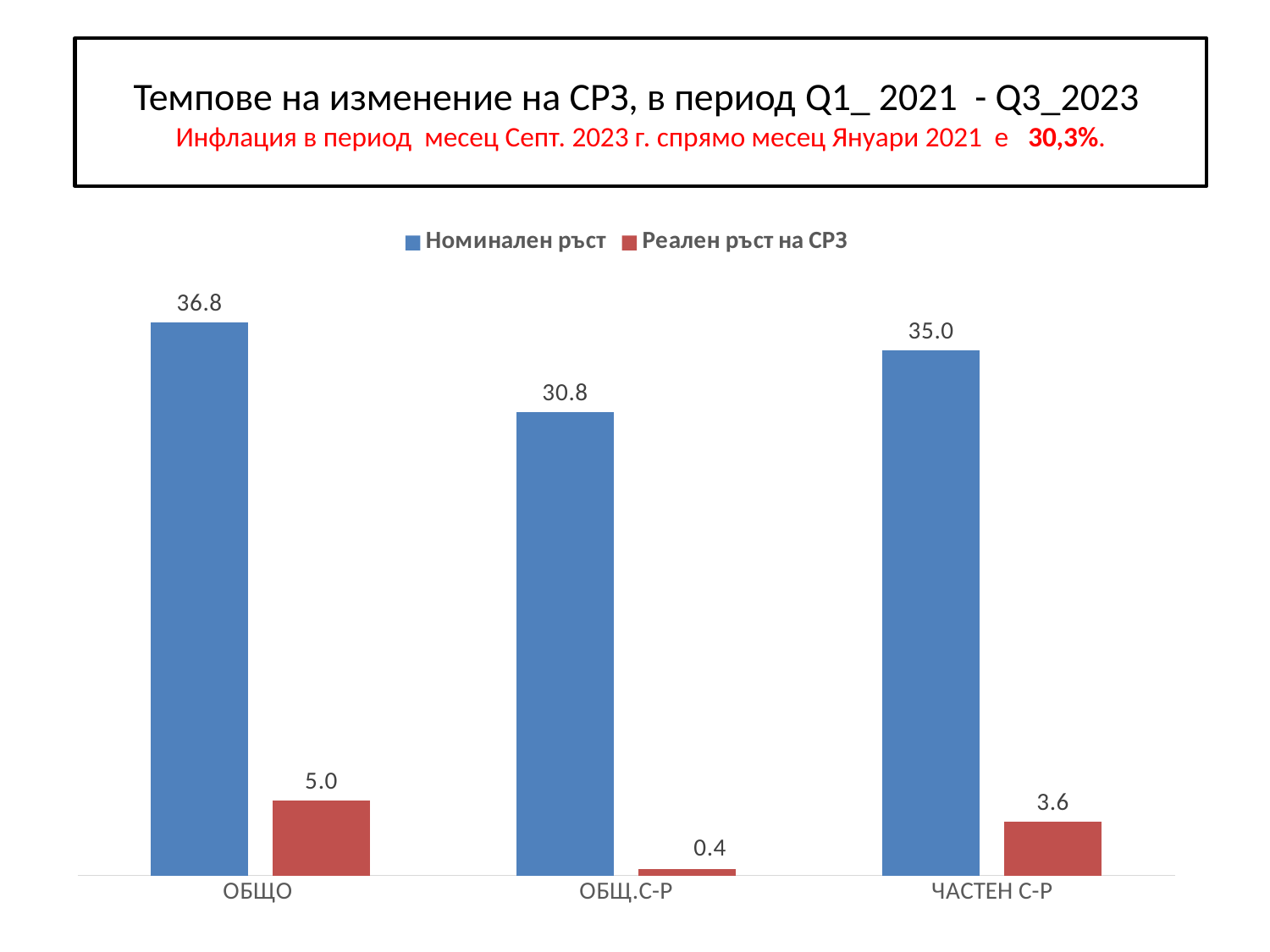
What is the difference in Номинален ръст between ОБЩО and ЧАСТЕН С-Р? 1.8 Which category has the lowest Реален ръст на СРЗ? ОБЩ.С-Р What kind of chart is shown on the slide? Bar chart What is the value of Реален ръст на СРЗ for ЧАСТЕН С-Р? 3.6 What is the value of Реален ръст на СРЗ for ОБЩ.С-Р? 0.4 How many series does the legend list? 2 What is the value of Номинален ръст for ОБЩО? 36.8 Which is larger: Реален ръст на СРЗ for ОБЩО or for ЧАСТЕН С-Р? ОБЩО What is the value of Номинален ръст for ОБЩ.С-Р? 30.8 What is the difference between Номинален ръст and Реален ръст на СРЗ for ОБЩО? 31.8 Which category has the highest Номинален ръст? ОБЩО How many categories are shown on the x axis? 3